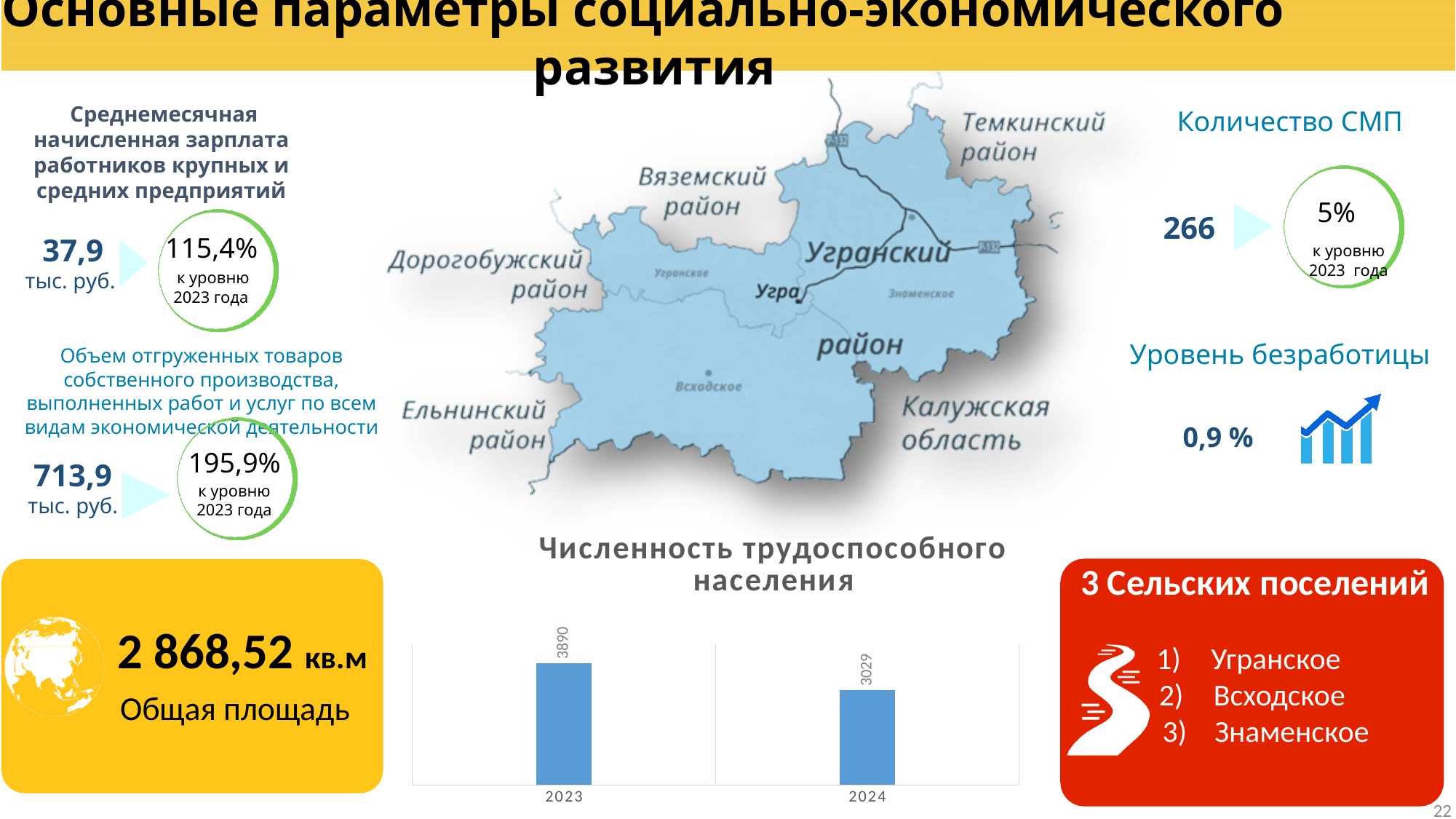
Do the values in the chart 'Численность трудоспособного населения' rise or fall from 2023 to 2024? fall How many bars are shown in the chart 'Численность трудоспособного населения'? 2 What is the title of the bar chart at the bottom centre of the slide? Численность трудоспособного населения Which year has the highest value in the chart 'Численность трудоспособного населения'? 2023 What is the difference between the 2023 and 2024 values in the chart 'Численность трудоспособного населения'? 861 What kind of chart is 'Численность трудоспособного населения'? bar chart What is the value for 2023 in the chart 'Численность трудоспособного населения'? 3890 Which year has the lowest value in the chart 'Численность трудоспособного населения'? 2024 In the chart 'Численность трудоспособного населения', which is larger: the value for 2023 or the value for 2024? 2023 What is the value for 2024 in the chart 'Численность трудоспособного населения'? 3029 What colour are the bars in the chart 'Численность трудоспособного населения'? blue